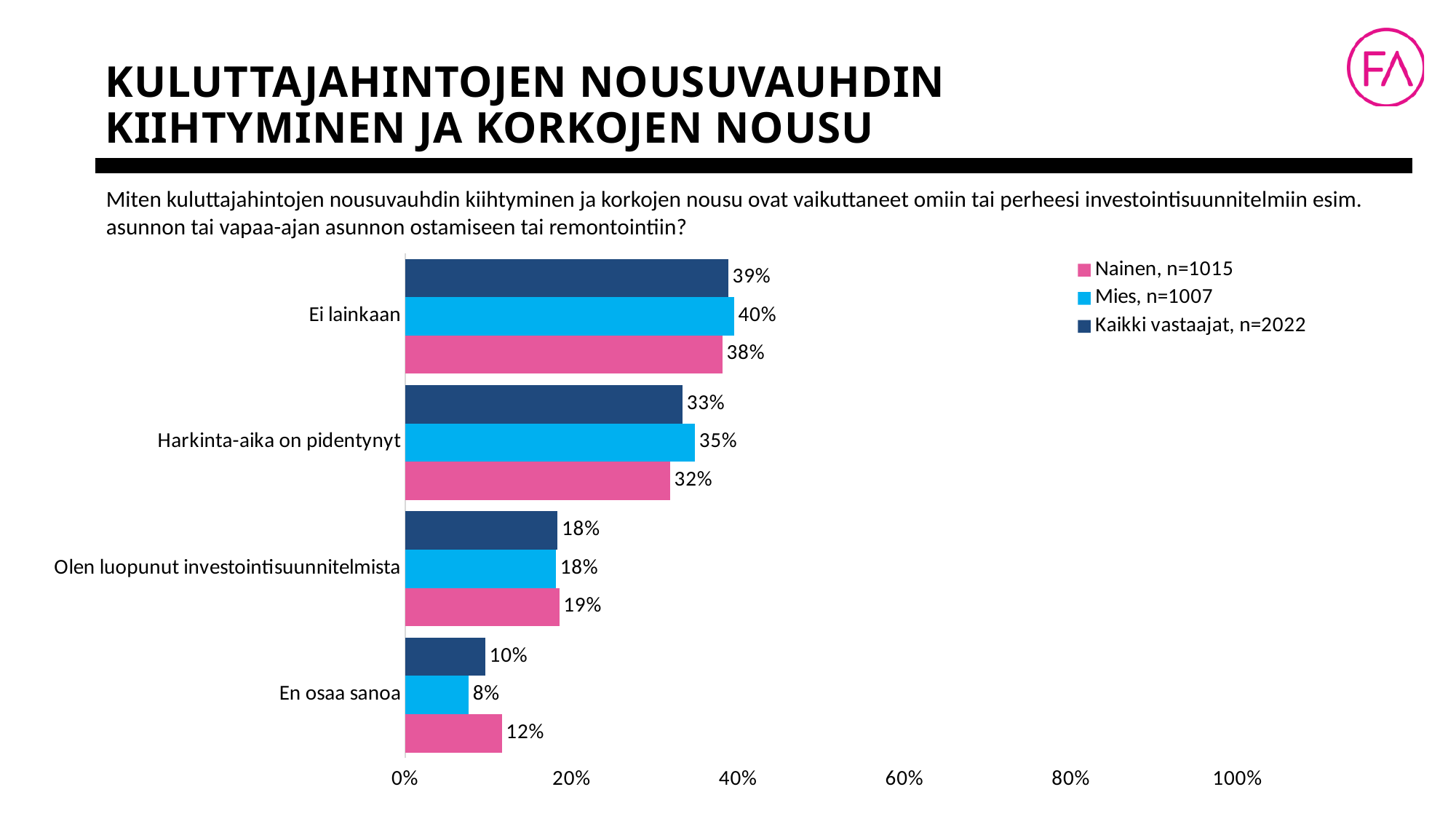
Which colour represents the "Nainen, n=1015" series? Pink What is the value for "Mies, n=1007" in the "Ei lainkaan" category? 40% Which category has the highest value for "Kaikki vastaajat, n=2022"? Ei lainkaan What kind of chart is shown on the slide? Bar chart What is the difference between the "Nainen, n=1015" and "Mies, n=1007" values in the "En osaa sanoa" category? 4% Which category has the lowest value for "Mies, n=1007"? En osaa sanoa What is the value for "Nainen, n=1015" in the "Harkinta-aika on pidentynyt" category? 32% What is the value for "Kaikki vastaajat, n=2022" in the "En osaa sanoa" category? 10% In the "Harkinta-aika on pidentynyt" category, which is larger: the value for "Mies, n=1007" or for "Nainen, n=1015"? Mies, n=1007 How many series does the legend list? 3 How many categories are shown on the chart? 4 What is the value for "Nainen, n=1015" in the "Olen luopunut investointisuunnitelmista" category? 19%